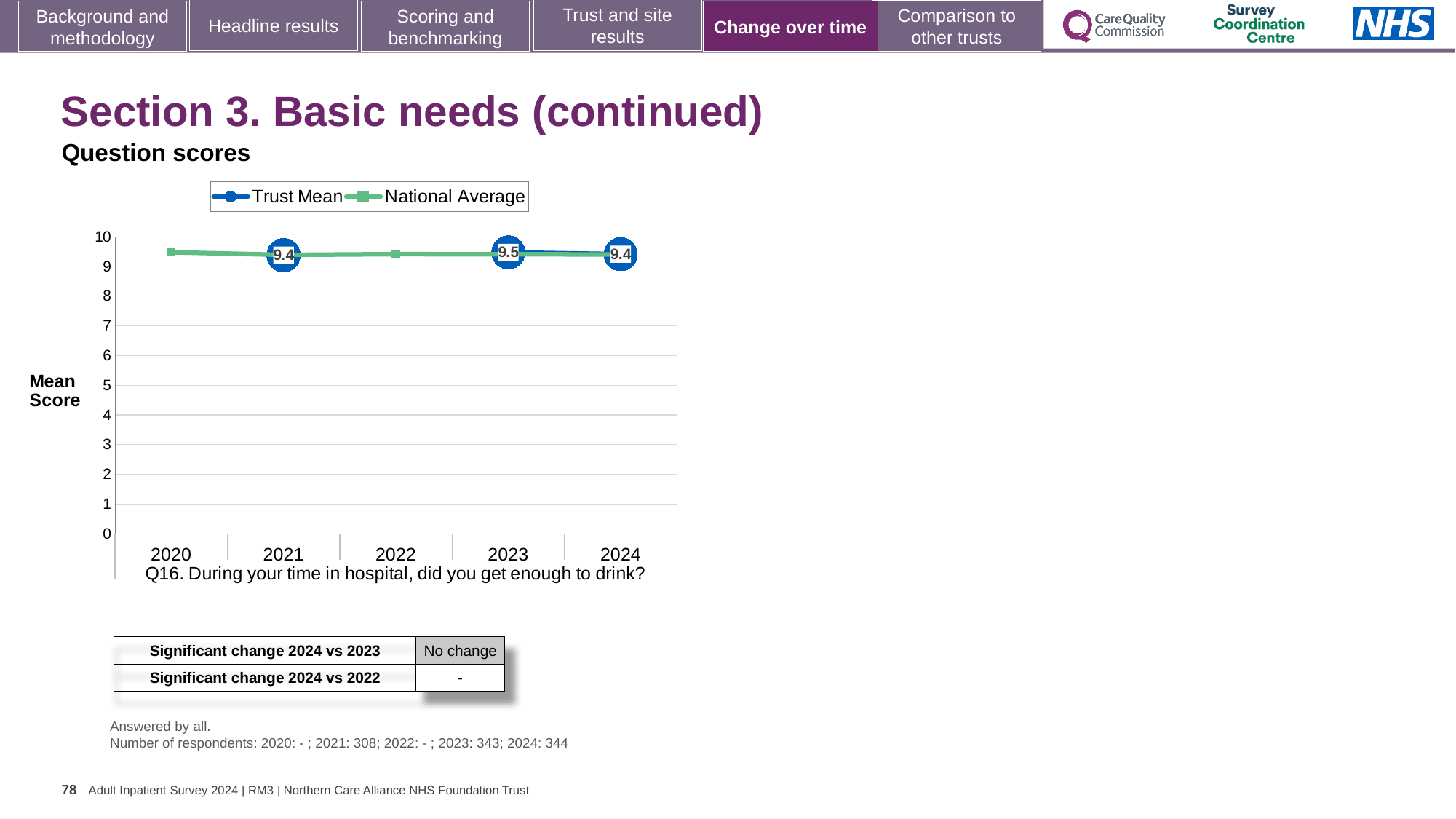
What is the Trust Mean score for 2021? 9.4 What is the Trust Mean score for 2023? 9.5 How many Trust Mean data points are labelled on the chart? 3 Which year has the larger Trust Mean score, 2021 or 2023? 2023 What is the Trust Mean score for 2024? 9.4 What is the label on the y axis of the chart? Mean Score Is the National Average value for 2020 greater or less than 9? greater How many series does the legend list? 2 How many years are shown on the x axis of the chart? 5 In which year is the Trust Mean score highest? 2023 What kind of chart is shown on the slide? Line chart What is the difference between the Trust Mean scores for 2023 and 2024? 0.1